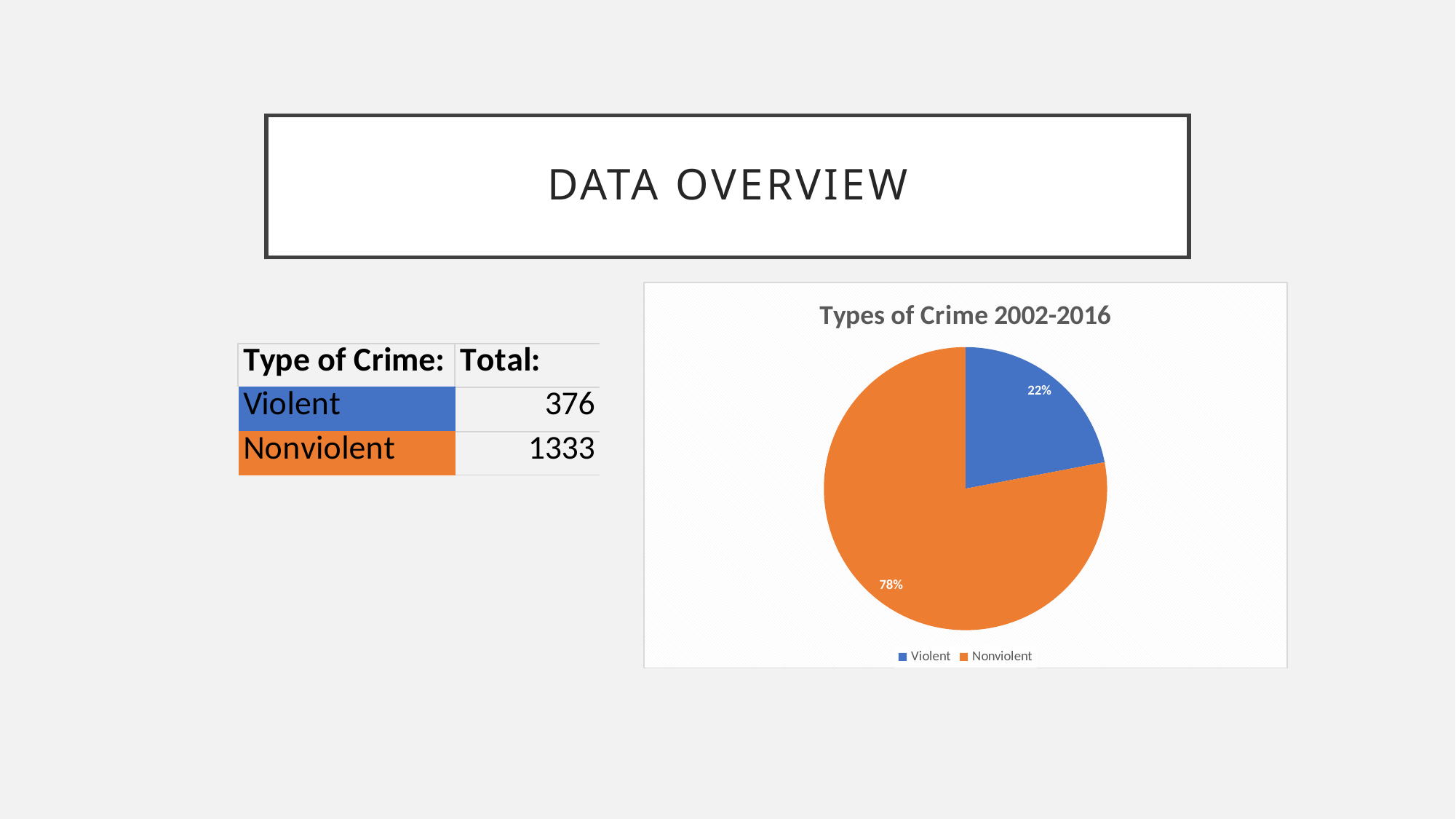
What percentage of the pie does the Nonviolent slice represent? 78% What percentage of the pie does the Violent slice represent? 22% How many entries does the chart legend list? 2 What kind of chart is shown on the slide? pie chart What is the difference in percentage points between the Nonviolent and Violent slices? 56 How many slices does the pie chart have? 2 Which slice is larger, Violent or Nonviolent? Nonviolent Which category has the smallest slice of the pie? Violent Which category has the largest slice of the pie? Nonviolent What is the title of the chart? Types of Crime 2002-2016 What colour is the Nonviolent slice in the pie chart? orange